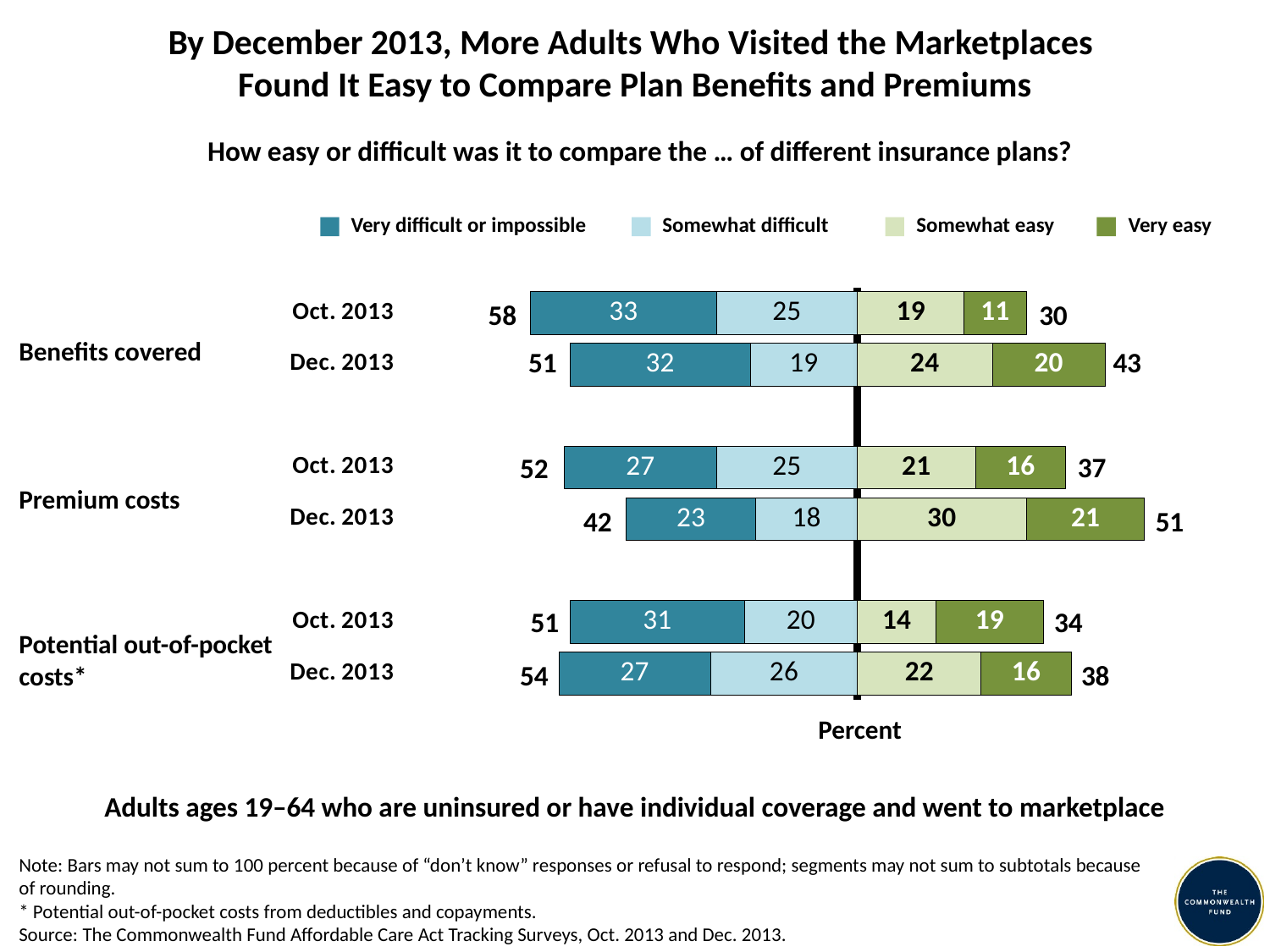
What is the combined 'difficult' subtotal shown for Premium costs in Oct. 2013? 52 What is the 'Very easy' value for Premium costs in Dec. 2013? 21 How many series does the legend list? 4 How many bars are plotted in the chart? 6 What is the difference between the 'Very difficult or impossible' values for Premium costs in Oct. 2013 and Dec. 2013? 4 What is the 'Somewhat easy' value for Potential out-of-pocket costs in Dec. 2013? 22 What kind of chart is shown on the slide? Stacked bar chart By how much did the 'Very easy' value for Benefits covered increase from Oct. 2013 to Dec. 2013? 9 Which bar has the highest 'Very difficult or impossible' value? Benefits covered, Oct. 2013 What percentage of adults found it very difficult or impossible to compare benefits covered in Oct. 2013? 33 For Benefits covered, which date has the larger 'Somewhat difficult' value, Oct. 2013 or Dec. 2013? Oct. 2013 What is the combined 'easy' subtotal shown for Potential out-of-pocket costs in Oct. 2013? 34